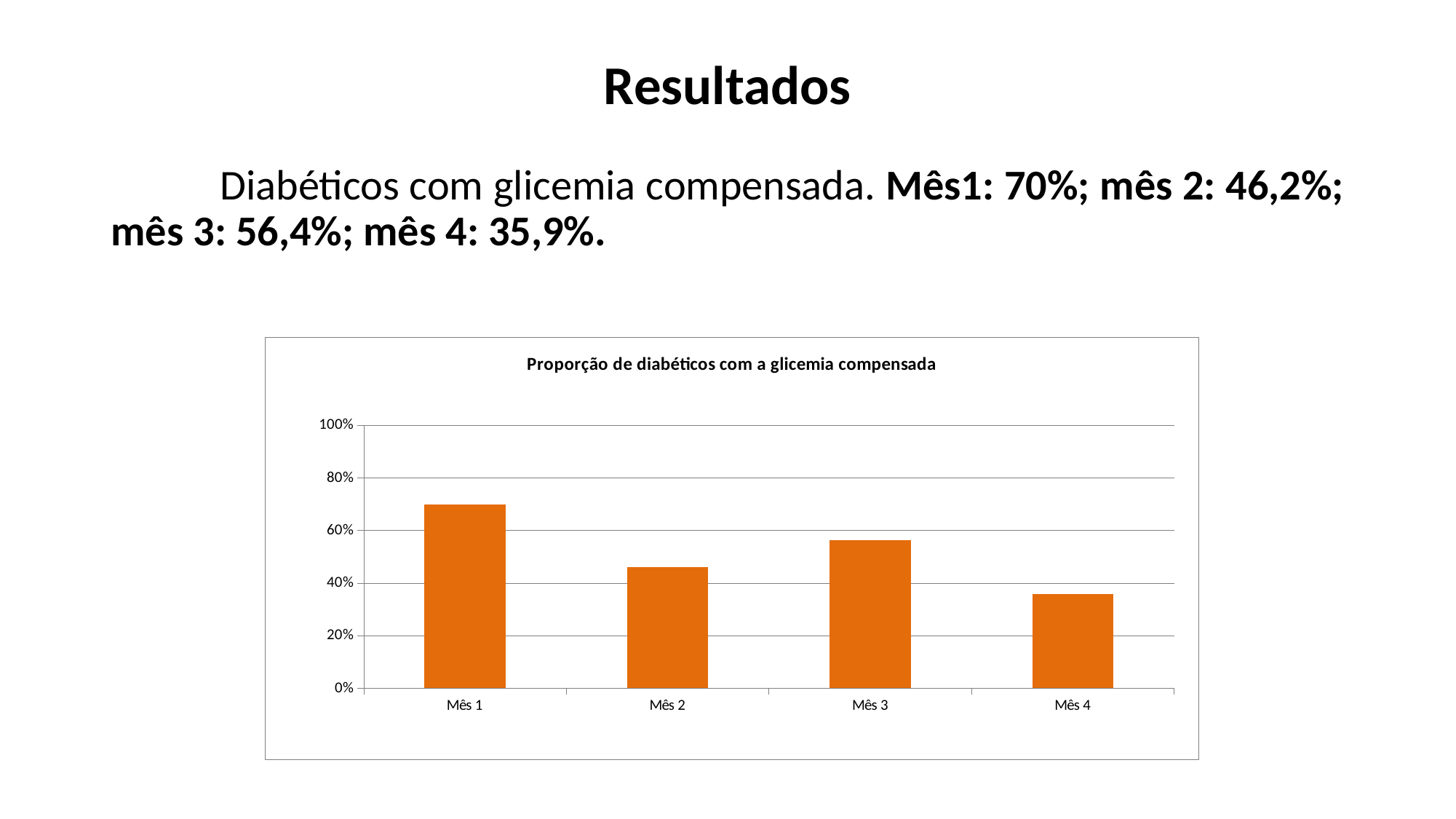
Which month has the highest proportion of diabetics with compensated glycemia? Mês 1 How many categories (months) are plotted on the chart? 4 What is the value for Mês 4? 35,9% What is the value for Mês 1? 70% What is the difference between the values for Mês 1 and Mês 2? 23,8% What is the value for Mês 3? 56,4% What is the value for Mês 2? 46,2% What is the title of the chart? Proporção de diabéticos com a glicemia compensada What type of chart is shown on the slide? bar chart Which is larger, the value for Mês 2 or the value for Mês 3? Mês 3 Is the value for Mês 4 greater or less than 40%? less Which month has the lowest proportion of diabetics with compensated glycemia? Mês 4